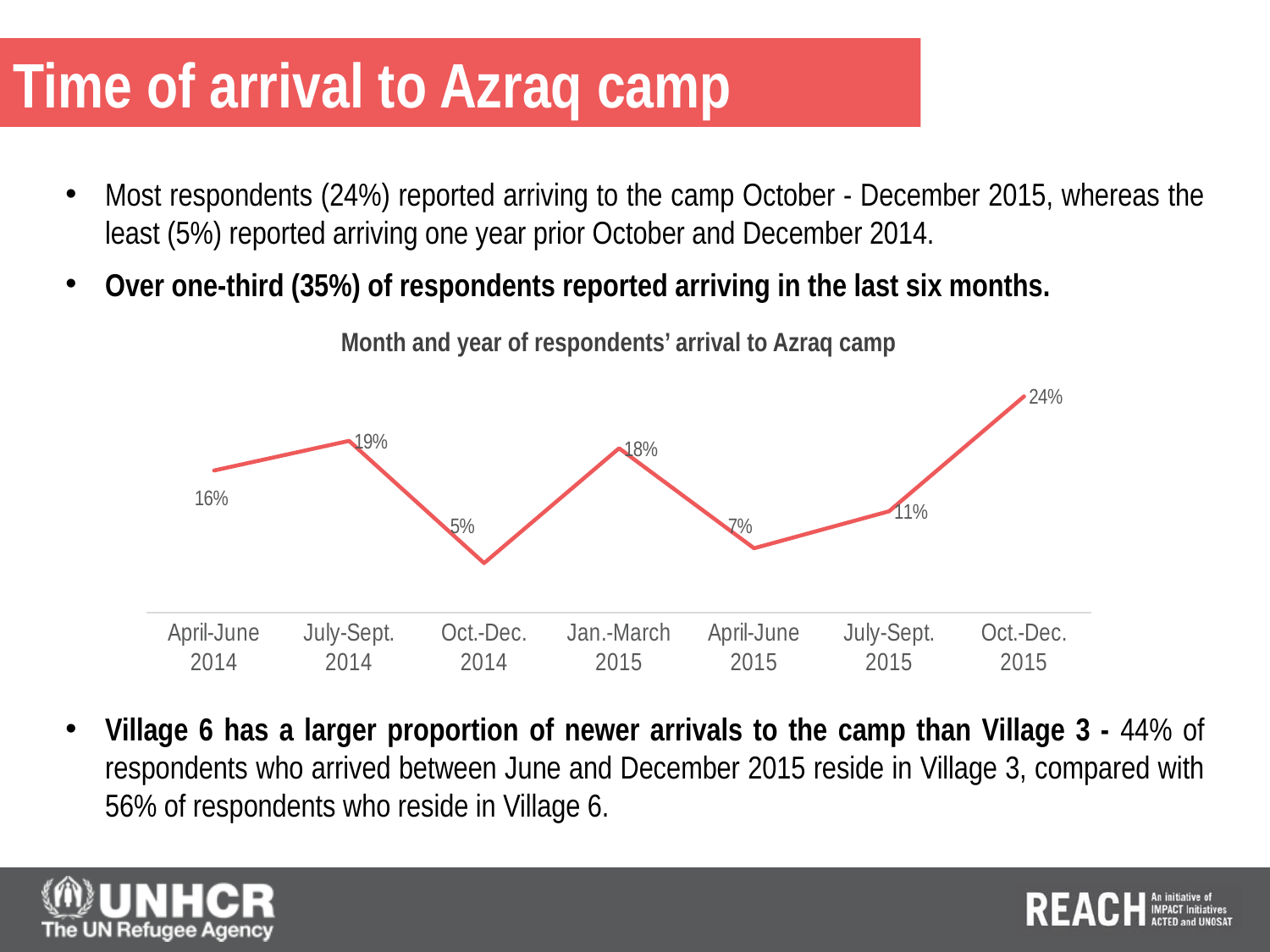
What percentage of respondents arrived in April-June 2014? 16% What percentage of respondents arrived in July-Sept. 2015? 11% What is the title of the chart? Month and year of respondents' arrival to Azraq camp How many time periods are shown on the x axis of the chart? 7 What percentage of respondents arrived in Oct.-Dec. 2014? 5% Which period has the lowest percentage of arrivals? Oct.-Dec. 2014 What type of chart is used to show the month and year of respondents' arrival? Line chart Which period has a larger percentage of arrivals, July-Sept. 2014 or April-June 2015? July-Sept. 2014 Which period has the highest percentage of arrivals? Oct.-Dec. 2015 What is the difference between the percentage arriving in Oct.-Dec. 2015 and Oct.-Dec. 2014? 19% Does the percentage of arrivals rise or fall from July-Sept. 2015 to Oct.-Dec. 2015? Rise What percentage of respondents arrived in Jan.-March 2015? 18%